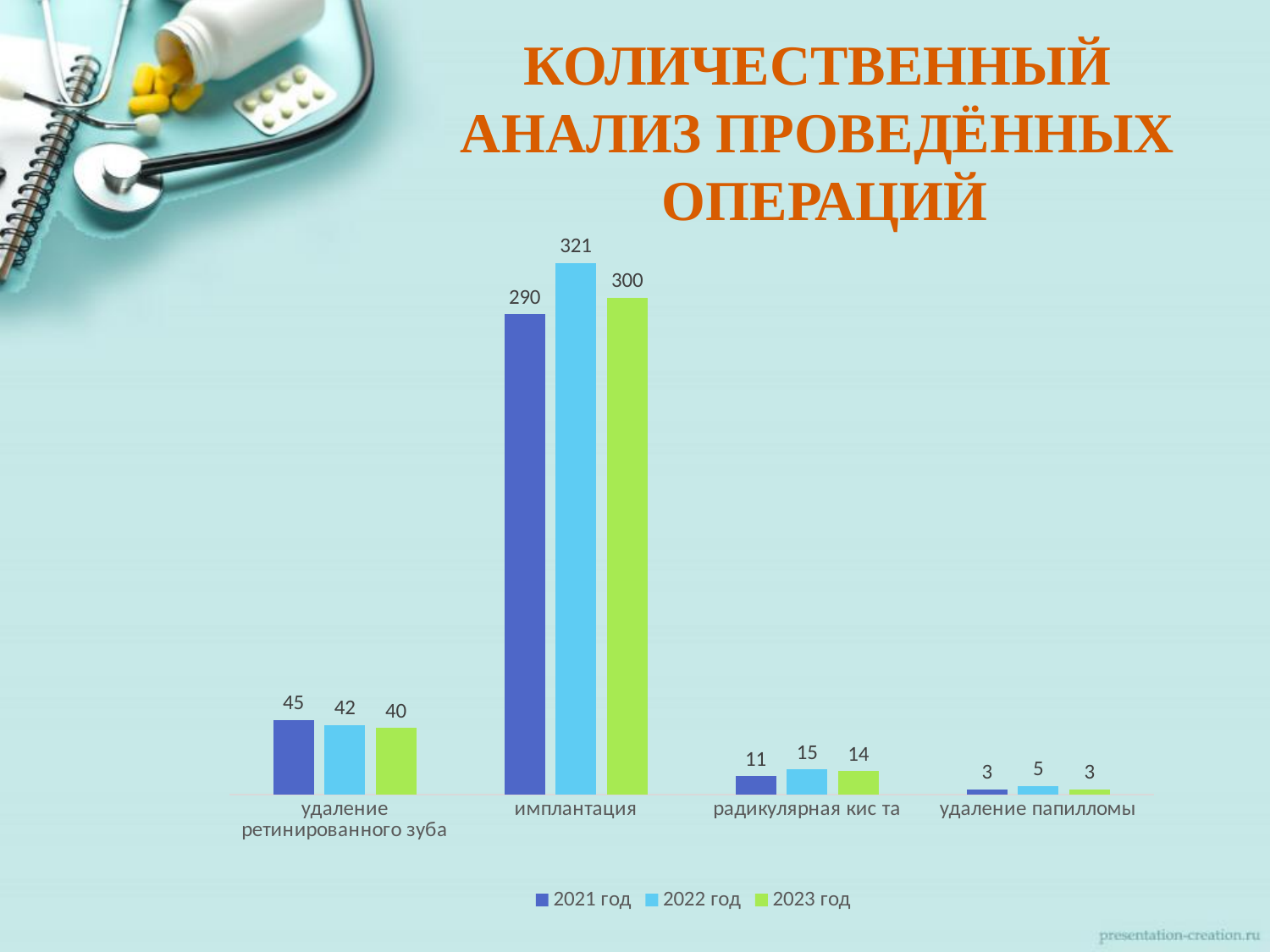
What is the title of the slide? КОЛИЧЕСТВЕННЫЙ АНАЛИЗ ПРОВЕДЁННЫХ ОПЕРАЦИЙ What is the value for имплантация in 2022 год? 321 What is the difference between the 2022 год and 2021 год values for имплантация? 31 What is the value for радикулярная киста in 2023 год? 14 Which category has the lowest value in 2023 год? удаление папилломы What kind of chart is shown on the slide? bar chart Which category has the highest value in 2021 год? имплантация How many categories are shown on the x axis? 4 What is the value for удаление ретинированного зуба in 2021 год? 45 Which is larger for радикулярная киста: the 2021 год value or the 2022 год value? 2022 год How many series does the legend list? 3 What is the value for удаление папилломы in 2022 год? 5